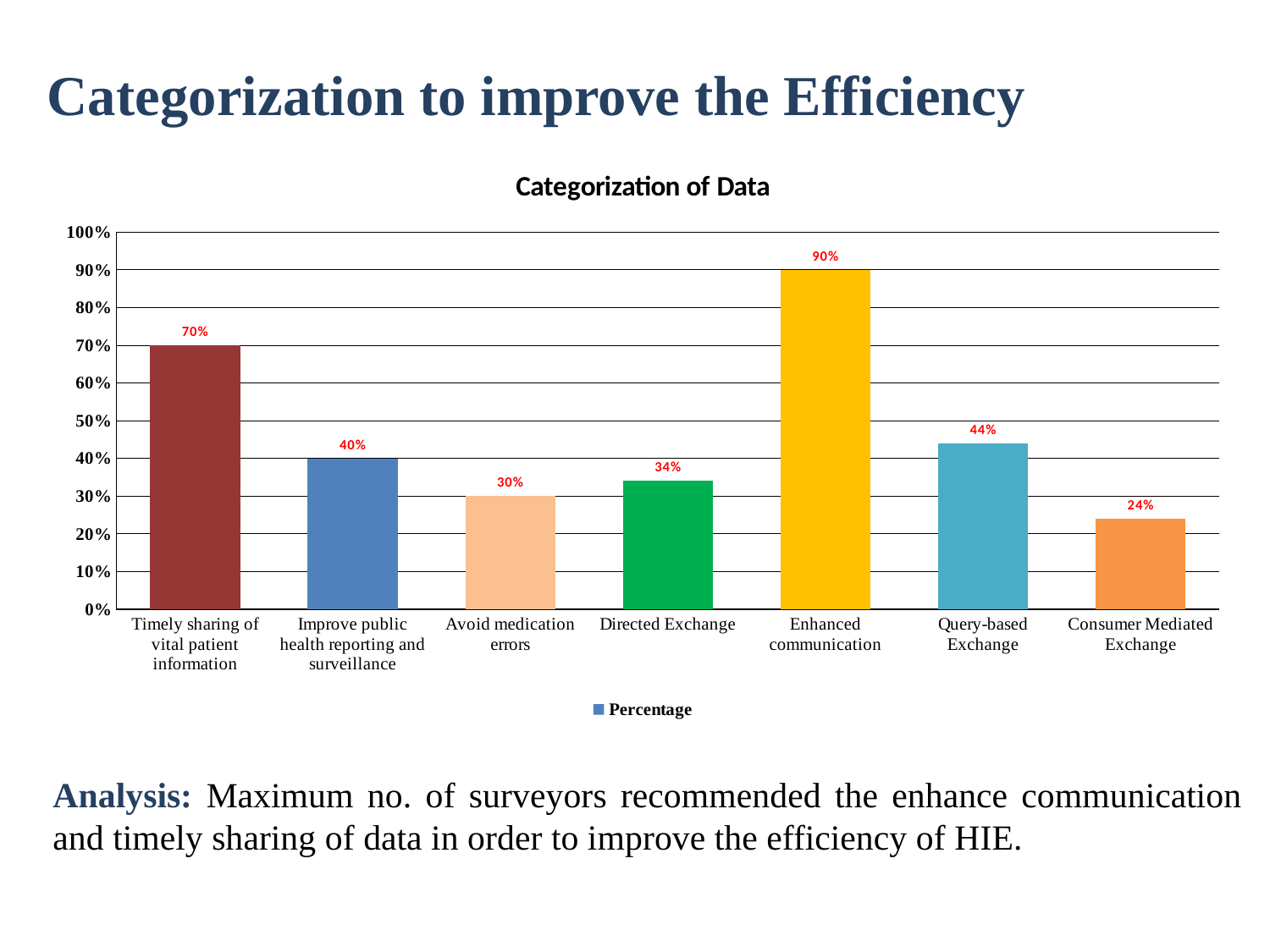
Which category has the highest value? Enhanced communication What is the value for Consumer Mediated Exchange? 24% What is the title of the chart? Categorization of Data Which category has the lowest value? Consumer Mediated Exchange What is the difference between the values for Query-based Exchange and Directed Exchange? 10% What is the difference between the values for Enhanced communication and Timely sharing of vital patient information? 20% Is the value for Query-based Exchange greater or less than 50%? less What kind of chart is shown on the slide? bar chart What is the value for Avoid medication errors? 30% What is the value for Enhanced communication? 90% Which is larger, the value for Improve public health reporting and surveillance or the value for Directed Exchange? Improve public health reporting and surveillance How many categories are shown on the x axis? 7